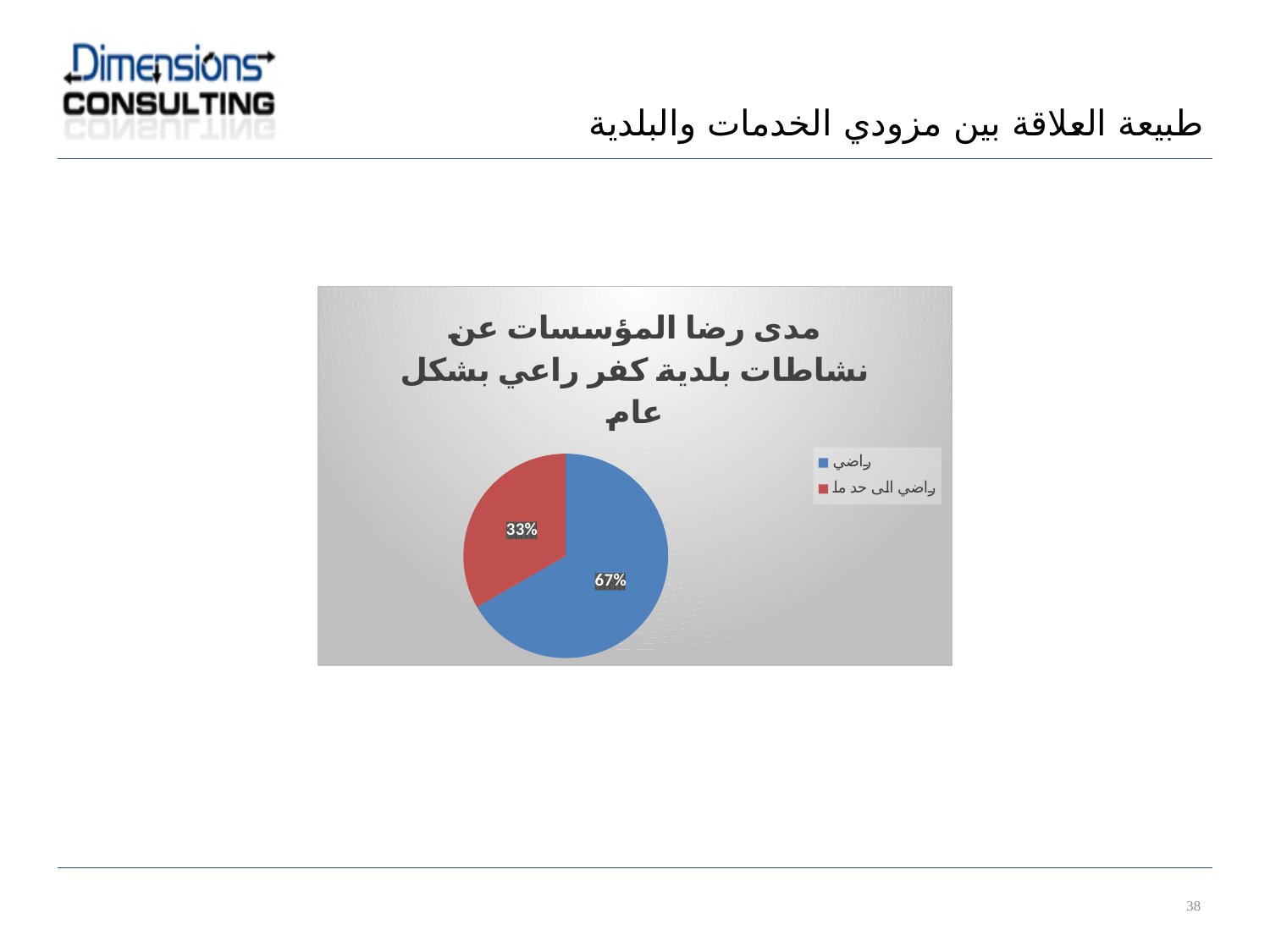
Which category has the smallest slice of the pie? راضي الى حد ما Which is larger, the "راضي" slice or the "راضي الى حد ما" slice? راضي How many slices does the pie chart have? 2 How many entries does the chart legend list? 2 Which category has the largest slice of the pie? راضي What kind of chart is shown on the slide? pie chart What colour is the "راضي الى حد ما" slice in the pie chart? red What share of the pie does the "راضي الى حد ما" slice represent? 33% What is the difference in percentage points between the "راضي" slice and the "راضي الى حد ما" slice? 34 What colour is the "راضي" slice in the pie chart? blue What share of the pie does the "راضي" slice represent? 67%